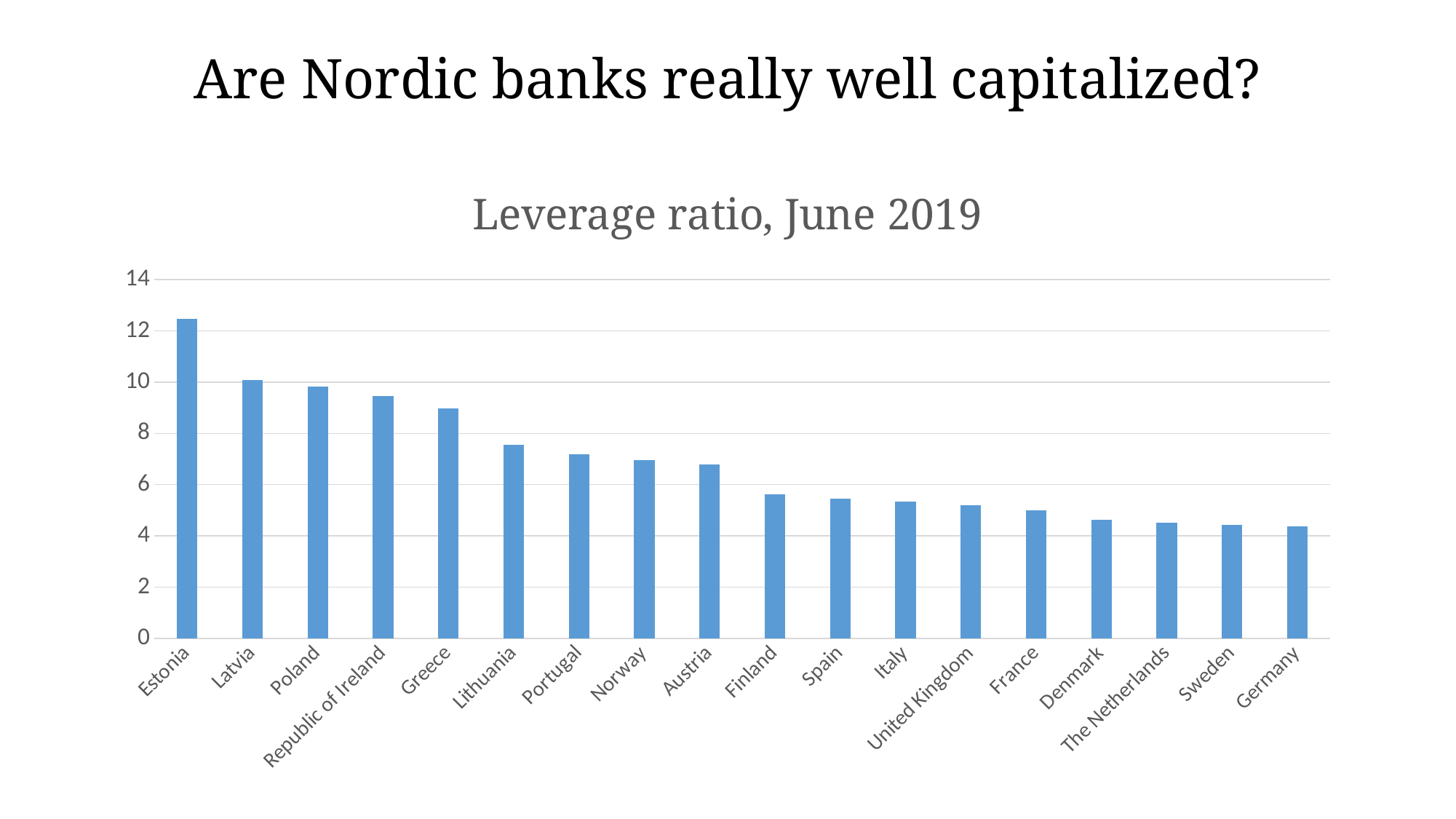
Do the values rise or fall moving from left to right along the x axis? Fall Which country has the highest leverage ratio in the chart? Estonia Which has the larger leverage ratio, Norway or Sweden? Norway Is the value for Finland greater or less than 6? less Is the value for Estonia greater or less than 12? greater How many countries are shown on the x axis of the chart? 18 Which has the larger leverage ratio, Finland or Denmark? Finland What is the title of the chart? Leverage ratio, June 2019 What kind of chart is shown on the slide? Bar chart Which has the larger leverage ratio, Greece or Lithuania? Greece Is the value for Lithuania greater or less than 8? less